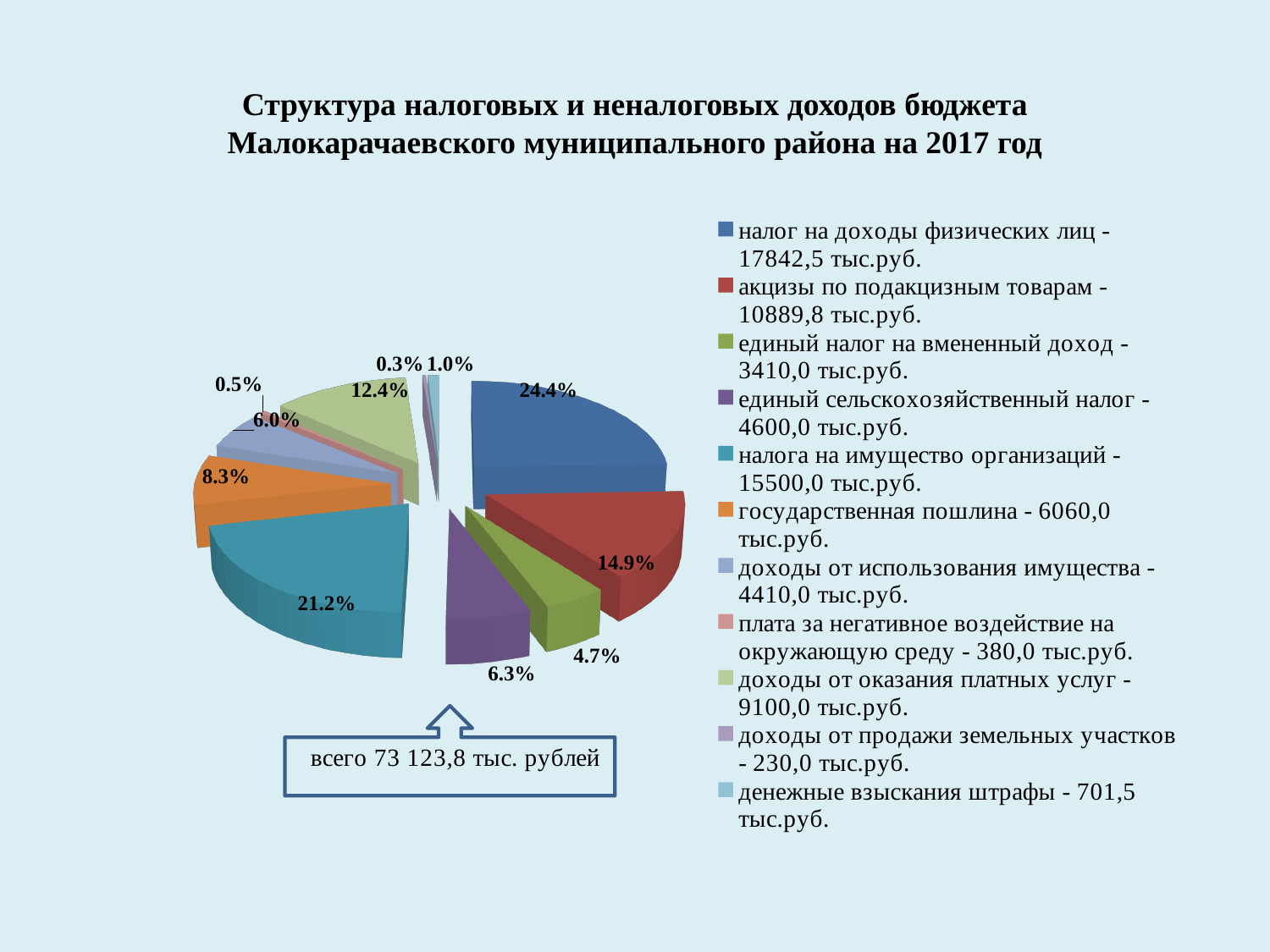
What share of the pie does "доходы от оказания платных услуг" take? 12.4% Which category has the smallest slice of the pie? доходы от продажи земельных участков What is the difference in percentage points between the slice for "налог на доходы физических лиц" and the slice for "налога на имущество организаций"? 3.2% How many entries does the legend list? 11 What share of the pie does "налог на доходы физических лиц" take? 24.4% According to the legend, what is the amount for "единый сельскохозяйственный налог"? 4600,0 тыс.руб. What share of the pie does "акцизы по подакцизным товарам" take? 14.9% What total amount is shown in the box below the pie chart? всего 73 123,8 тыс. рублей Which category has the largest slice of the pie? налог на доходы физических лиц Which is larger: the slice for "государственная пошлина" or the slice for "единый сельскохозяйственный налог"? государственная пошлина What kind of chart is shown on the slide? pie chart